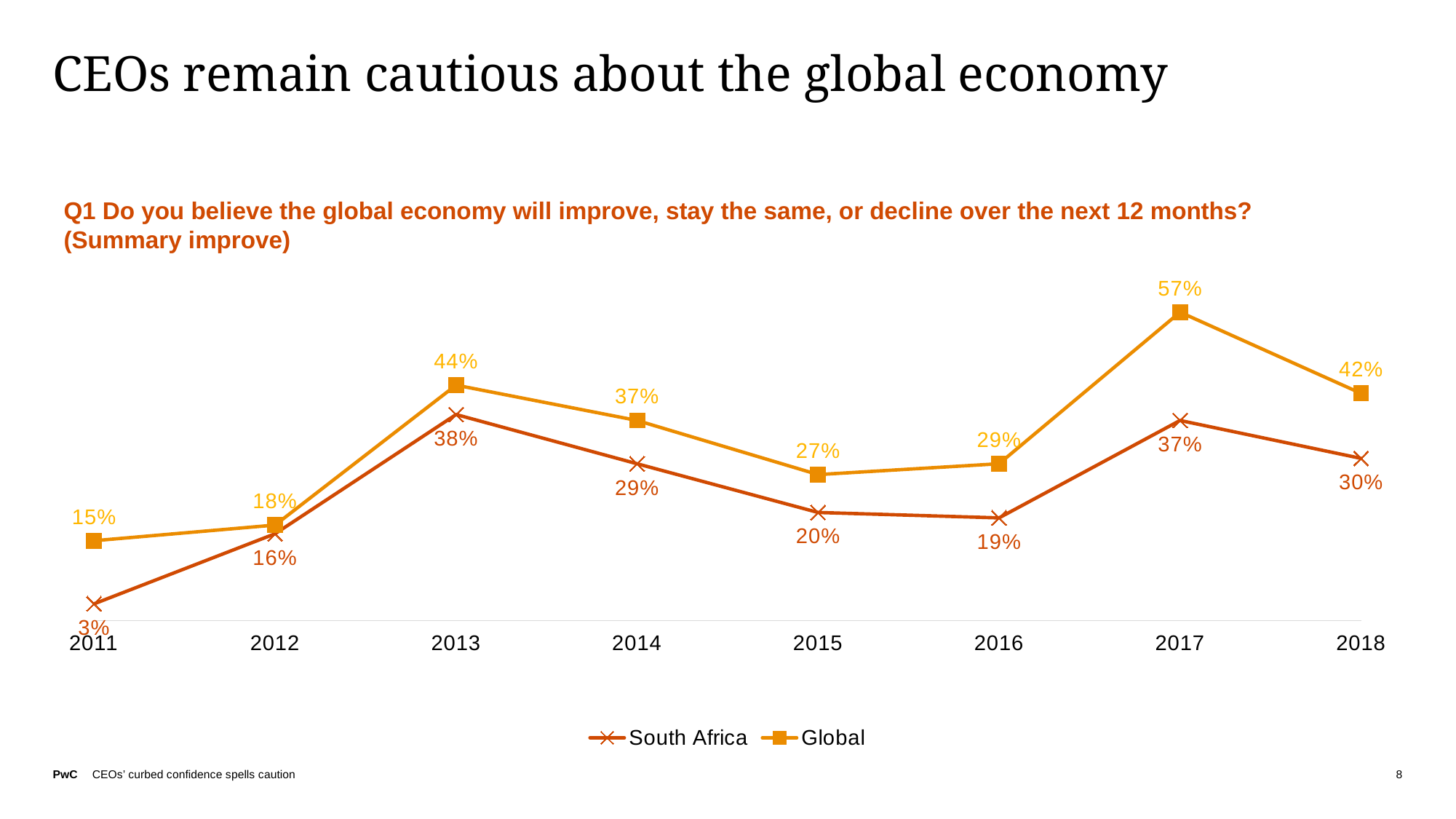
What is the South Africa value for 2011? 3% Which is larger in 2014, the Global value or the South Africa value? Global What is the Global value for 2013? 44% Does the Global series rise or fall from 2017 to 2018? Fall How many years are shown on the x axis? 8 In which year is the South Africa series lowest? 2011 How many series does the legend list? 2 In which year is the Global series highest? 2017 What is the South Africa value for 2015? 20% What is the difference between the Global and South Africa values in 2018? 12% What kind of chart is shown on the slide? Line chart What is the Global value for 2017? 57%